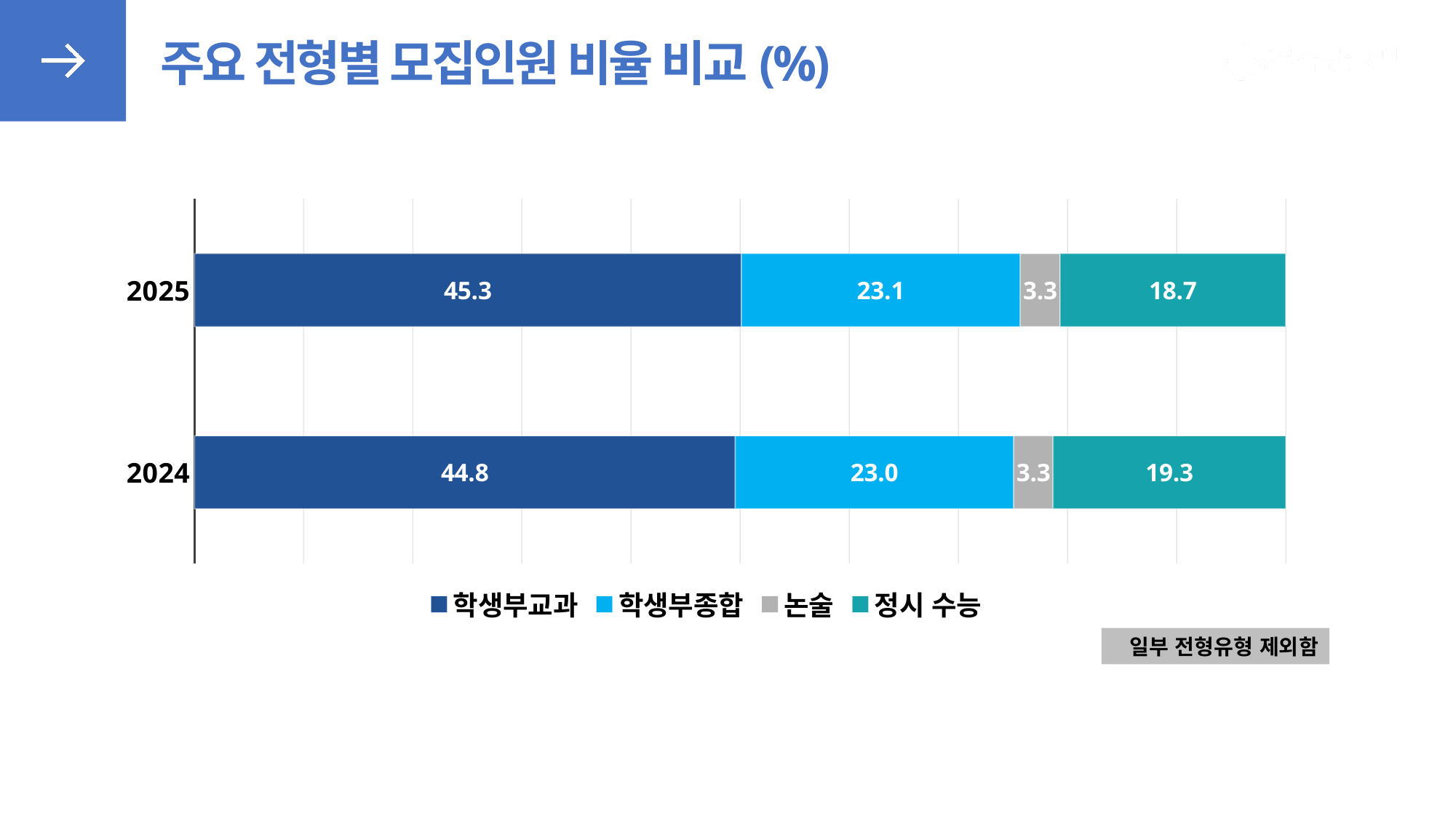
What is the value for 논술 in 2024? 3.3 What is the total of the stacked bar for 2025? 90.4 What kind of chart is shown on the slide? Stacked bar chart What is the value for 정시 수능 in 2024? 19.3 Which series has the largest value in the 2025 bar? 학생부교과 What is the value for 학생부교과 in 2025? 45.3 Which series has the smallest value in the 2024 bar? 논술 What is the difference between the 정시 수능 values for 2024 and 2025? 0.6 How many series does the legend list? 4 Which year has the larger value for 정시 수능, 2025 or 2024? 2024 What is the value for 학생부종합 in 2025? 23.1 What is the difference between the 학생부교과 values for 2025 and 2024? 0.5